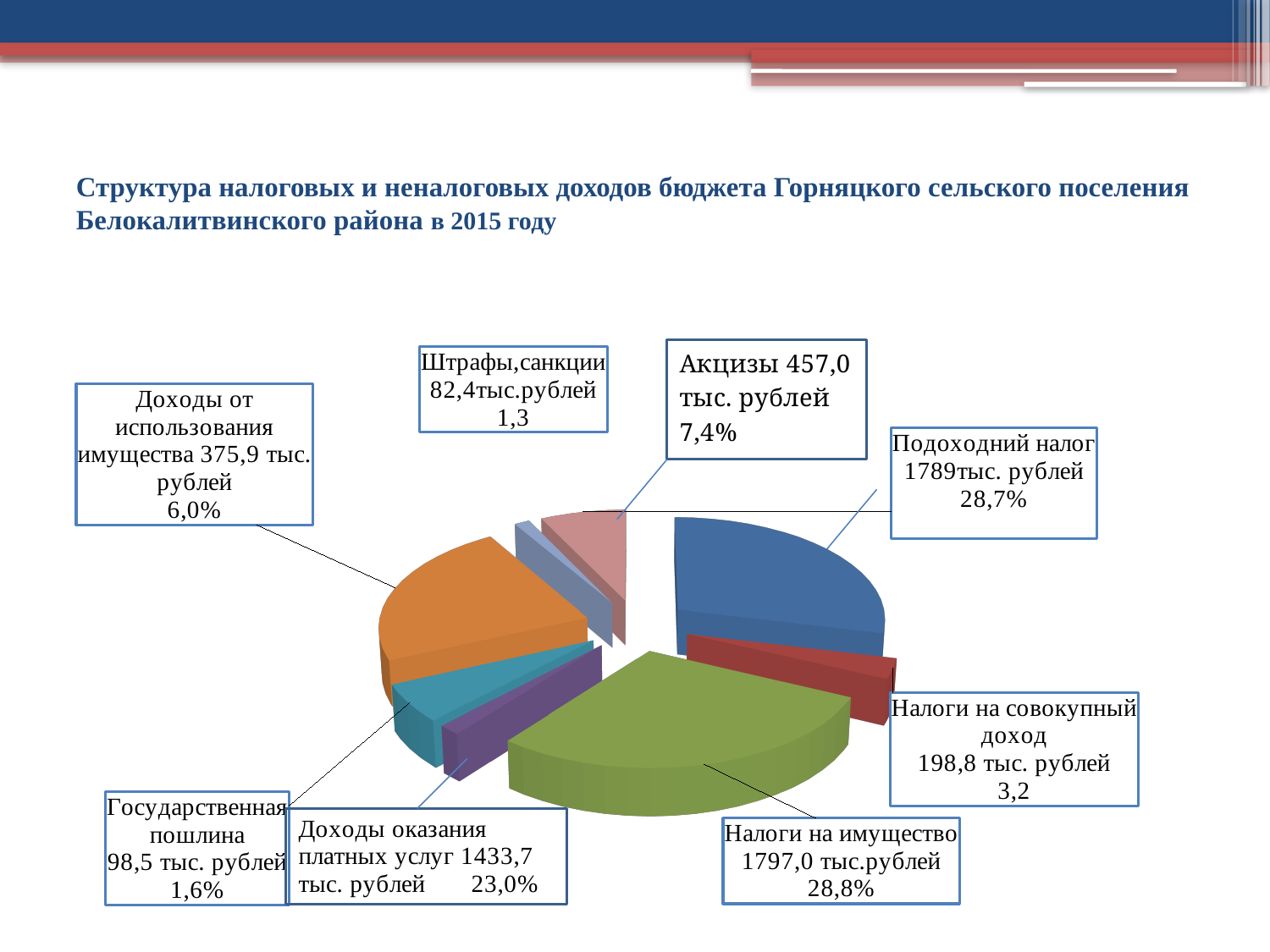
What is the value for Акцизы? 457,0 тыс. рублей What share of the pie does Подоходный налог represent? 28,7% Which category has the smallest value? Штрафы,санкции What is the value for Налоги на имущество? 1797,0 тыс.рублей What kind of chart is shown on the slide? pie chart What is the value for Государственная пошлина? 98,5 тыс. рублей How many slices does the pie chart have? 8 What is the title of the chart on the slide? Структура налоговых и неналоговых доходов бюджета Горняцкого сельского поселения Белокалитвинского района в 2015 году Which category has the largest value according to the printed labels? Налоги на имущество Which is larger: Доходы от использования имущества or Налоги на совокупный доход? Доходы от использования имущества What is the difference between the values for Акцизы and Доходы от использования имущества (in тыс. рублей)? 81,1 What share of the pie does Доходы оказания платных услуг represent? 23,0%